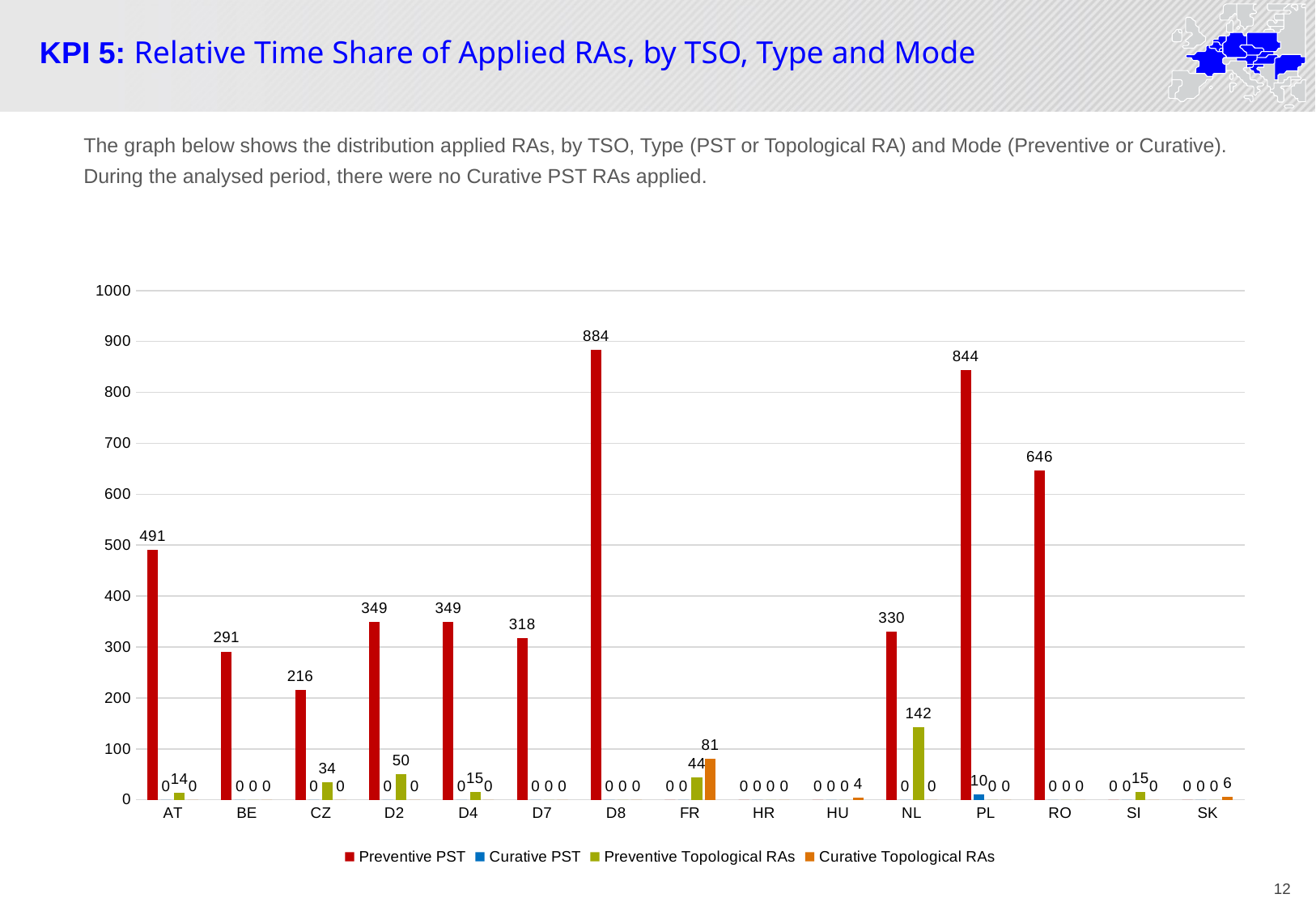
What kind of chart is shown on the slide? bar chart What colour represents Preventive PST in the legend? red How many TSO categories are shown on the x axis? 15 Which has the larger Preventive PST value, RO or AT? RO What is the Preventive PST value for D8? 884 Which TSO has the highest Preventive Topological RAs value? NL What is the Preventive Topological RAs value for NL? 142 How many series does the legend list? 4 What is the difference between the Preventive PST values for D8 and PL? 40 What is the Curative Topological RAs value for FR? 81 For NL, what is the difference between the Preventive PST value and the Preventive Topological RAs value? 188 Which TSO has the highest Preventive PST value? D8